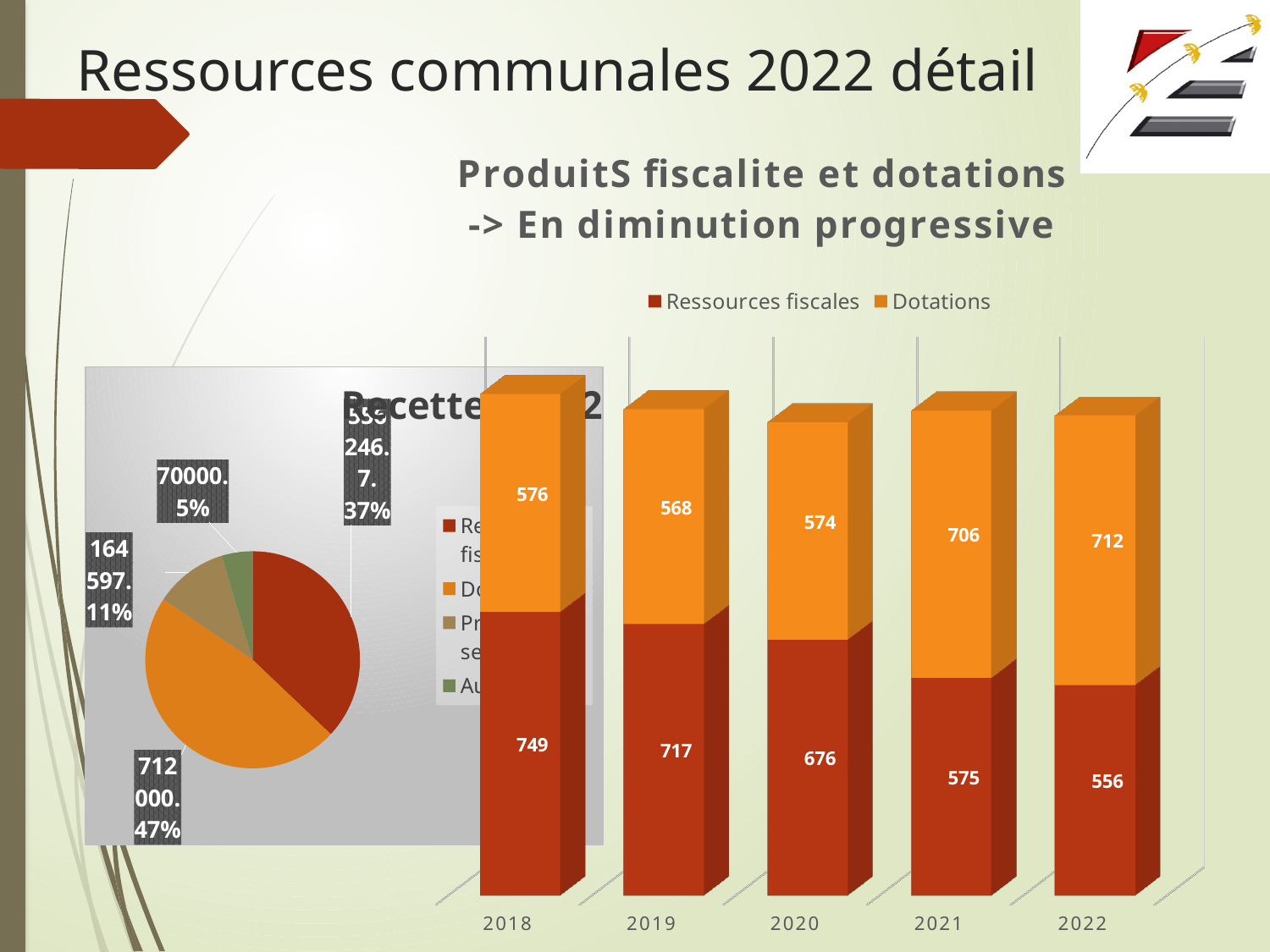
What kind of chart is shown on the left of the slide? pie chart In the stacked bar chart on the right, which is larger in 2021: Ressources fiscales or Dotations? Dotations In the stacked bar chart on the right, how many series does the legend list? 2 In the stacked bar chart on the right, what is the value of Dotations for 2020? 574 In the stacked bar chart on the right, what is the value of Ressources fiscales for 2018? 749 In the stacked bar chart on the right, which year has the lowest value for Ressources fiscales? 2022 In the stacked bar chart on the right, do the Ressources fiscales values rise or fall from 2018 to 2022? fall In the stacked bar chart on the right, what is the total of the 2019 bar? 1285 In the stacked bar chart on the right, which year has the highest value for Ressources fiscales? 2018 In the stacked bar chart on the right, how many years are shown on the x axis? 5 In the stacked bar chart on the right, what is the value of Dotations for 2022? 712 In the stacked bar chart on the right, what is the difference between Ressources fiscales in 2018 and in 2022? 193